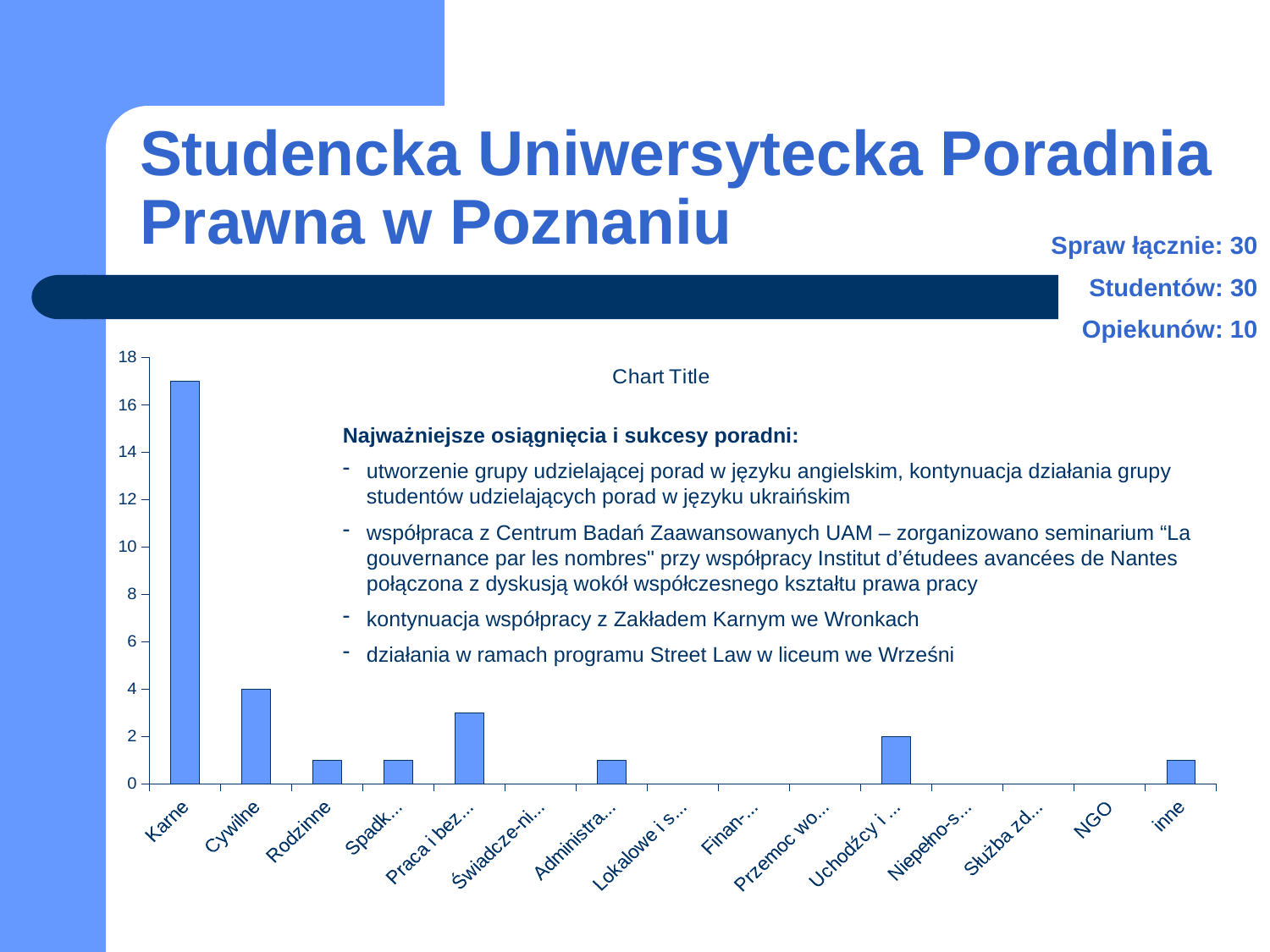
What kind of chart is shown on the slide? bar chart What is the title shown on the chart? Chart Title How many categories are shown on the x axis of the chart? 15 What is the difference between the value for Cywilne and the value for Uchodźcy i ...? 2 What is the value for Uchodźcy i ...? 2 Is the value for Karne greater or less than 16? greater Which is larger, the value for Karne or the value for Cywilne? Karne What is the value for Cywilne? 4 Is the value for Praca i bez... greater or less than 4? less Which category has the highest bar in the chart? Karne Is the value for Rodzinne greater or less than 2? less